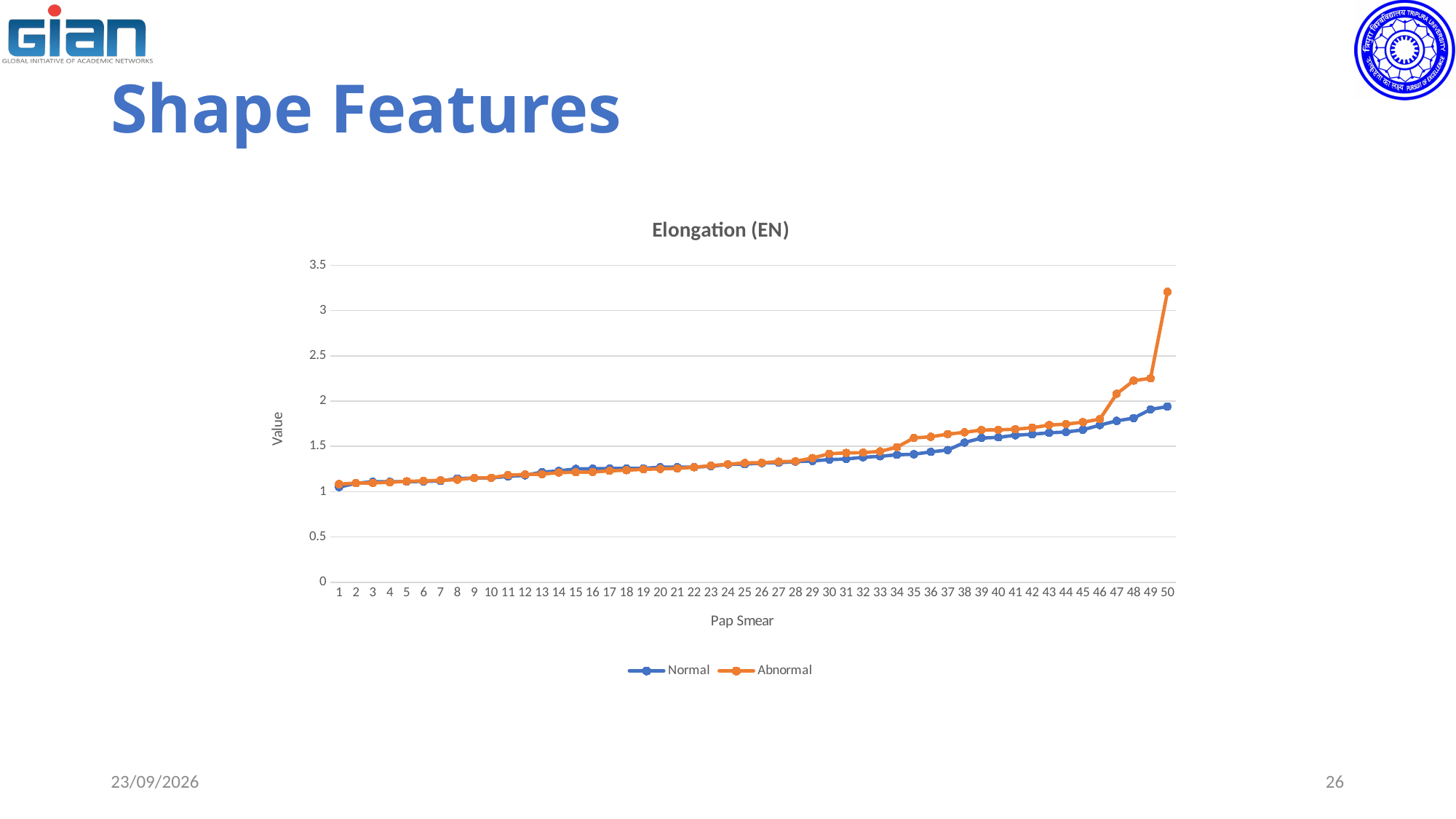
Is the Abnormal value at Pap Smear 48 greater or less than 2? greater At Pap Smear 50, which series has the larger value, Normal or Abnormal? Abnormal Is the Normal value at Pap Smear 50 greater or less than 2? less How many Pap Smear points are plotted along the x axis? 50 How many series does the legend list? 2 What kind of chart is shown on the slide? Line chart What is the label of the x axis? Pap Smear At which Pap Smear number does the Abnormal series reach its highest value? 50 Is the Abnormal value at Pap Smear 50 greater or less than 3? greater Do the values of the Abnormal series rise or fall as the Pap Smear number increases? Rise What is the title of the chart? Elongation (EN)